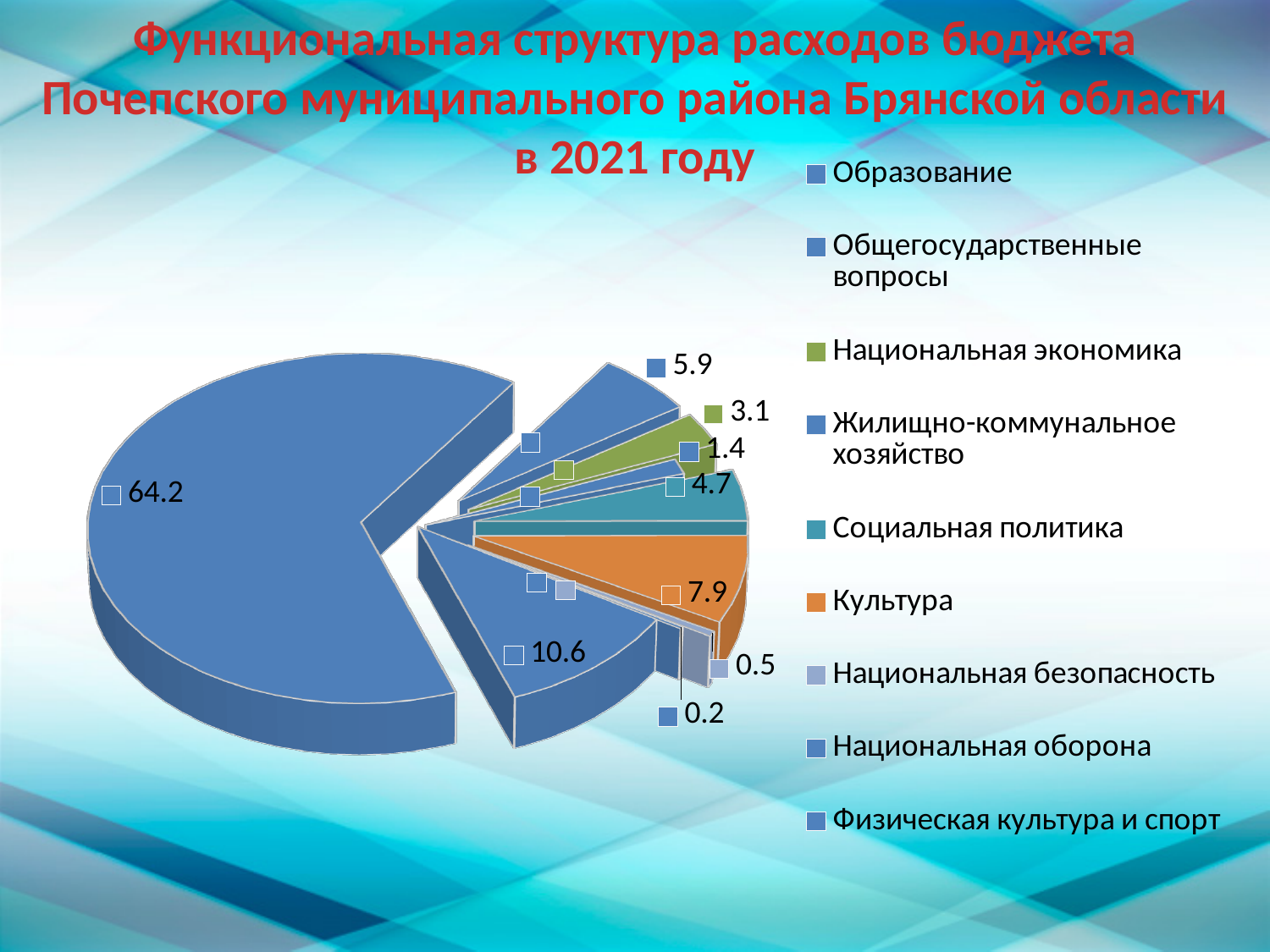
What value is shown for Социальная политика? 4.7 What kind of chart is shown on the slide? pie chart What is the difference between the values for Культура and Социальная политика? 3.2 What value is shown for Национальная экономика? 3.1 How many categories does the legend of the pie chart list? 9 What value is shown for the largest slice (Образование)? 64.2 Which is larger, the value for Культура or the value for Национальная экономика? Культура Which colour is used for the Культура slice in the pie chart? orange Which category has the largest slice of the pie chart? Образование What is the smallest value labelled on the pie chart? 0.2 What value is shown for Культура? 7.9 What value is shown for Национальная безопасность? 0.5